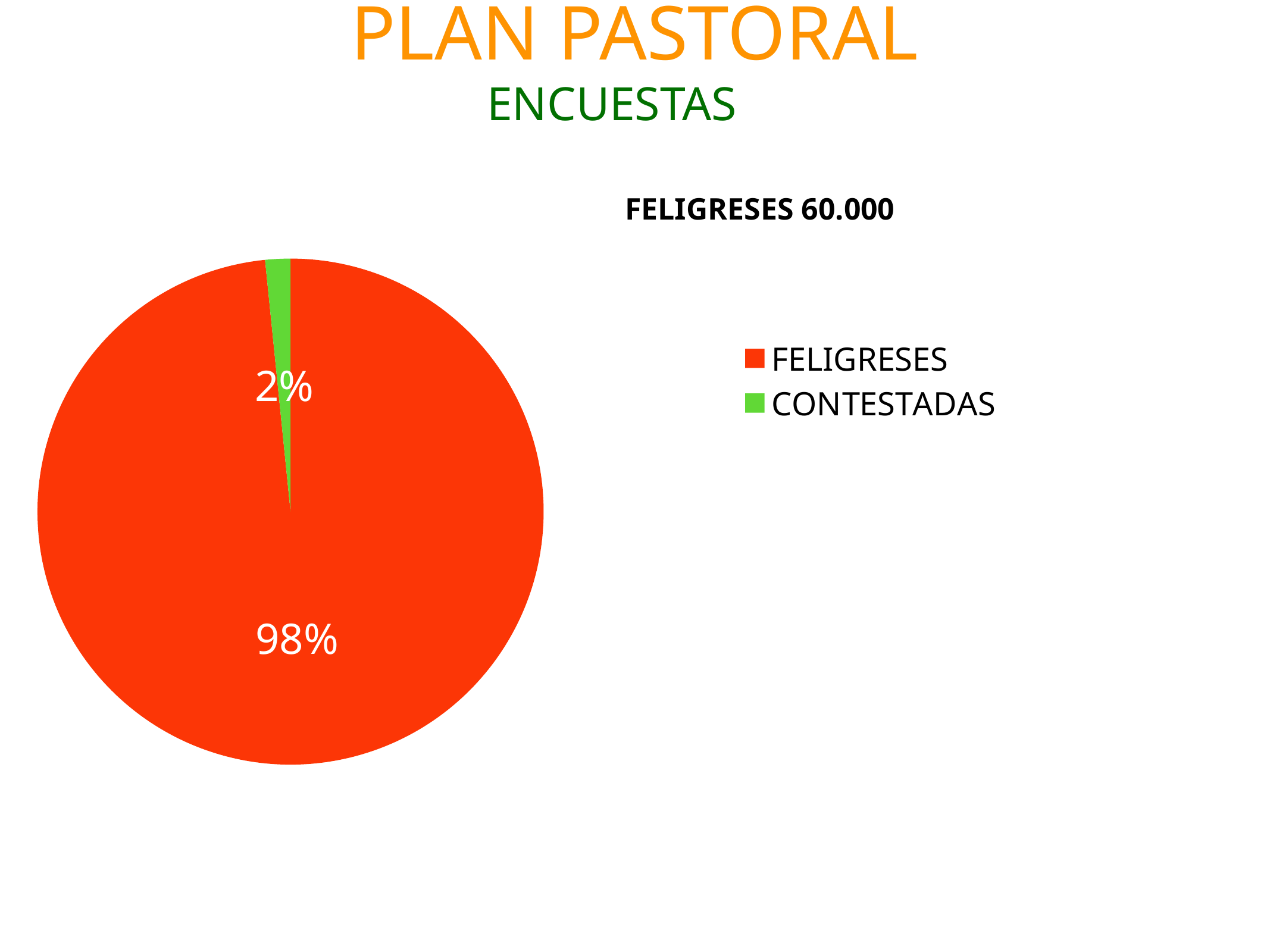
What kind of chart is shown on the slide? pie chart Which slice of the pie is the largest? FELIGRESES What is the title shown above the chart's legend area? FELIGRESES 60.000 How many entries does the legend list? 2 What percentage of the pie does the FELIGRESES slice represent? 98% Which is larger, the FELIGRESES slice or the CONTESTADAS slice? FELIGRESES How many slices does the pie chart have? 2 Which slice of the pie is the smallest? CONTESTADAS What is the difference in percentage points between the FELIGRESES slice and the CONTESTADAS slice? 96 What colour is the CONTESTADAS slice in the pie chart? green What percentage of the pie does the CONTESTADAS slice represent? 2%